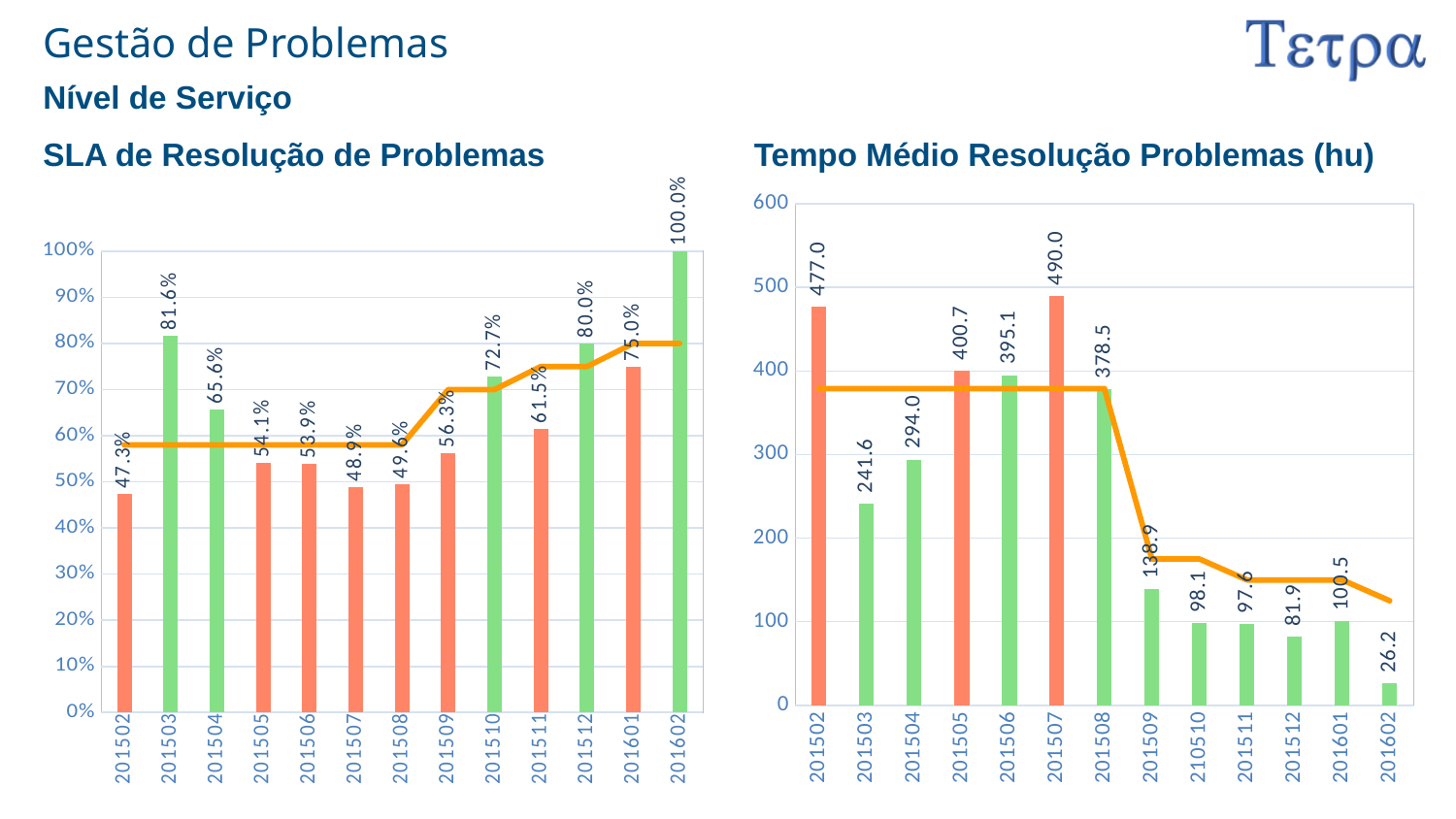
In the chart titled 'SLA de Resolução de Problemas', what is the difference between the values for 201602 and 201601? 25.0% In the chart titled 'Tempo Médio Resolução Problemas (hu)', what is the value for 201507? 490.0 In the chart titled 'SLA de Resolução de Problemas', which period has the highest value? 201602 In the chart titled 'Tempo Médio Resolução Problemas (hu)', do the bar values rise or fall from 201509 to 201512? fall In the chart titled 'Tempo Médio Resolução Problemas (hu)', what is the difference between the values for 201502 and 201503? 235.4 In the chart titled 'SLA de Resolução de Problemas', which period has the lowest value? 201502 In the chart titled 'Tempo Médio Resolução Problemas (hu)', which period has the highest value? 201507 How many periods are shown on the x axis of the chart titled 'Tempo Médio Resolução Problemas (hu)'? 13 What kind of chart is the one titled 'SLA de Resolução de Problemas'? combination bar and line chart In the chart titled 'Tempo Médio Resolução Problemas (hu)', which is larger, the value for 201505 or for 201506? 201505 In the chart titled 'Tempo Médio Resolução Problemas (hu)', which period has the lowest value? 201602 In the chart titled 'SLA de Resolução de Problemas', what is the value for 201503? 81.6%